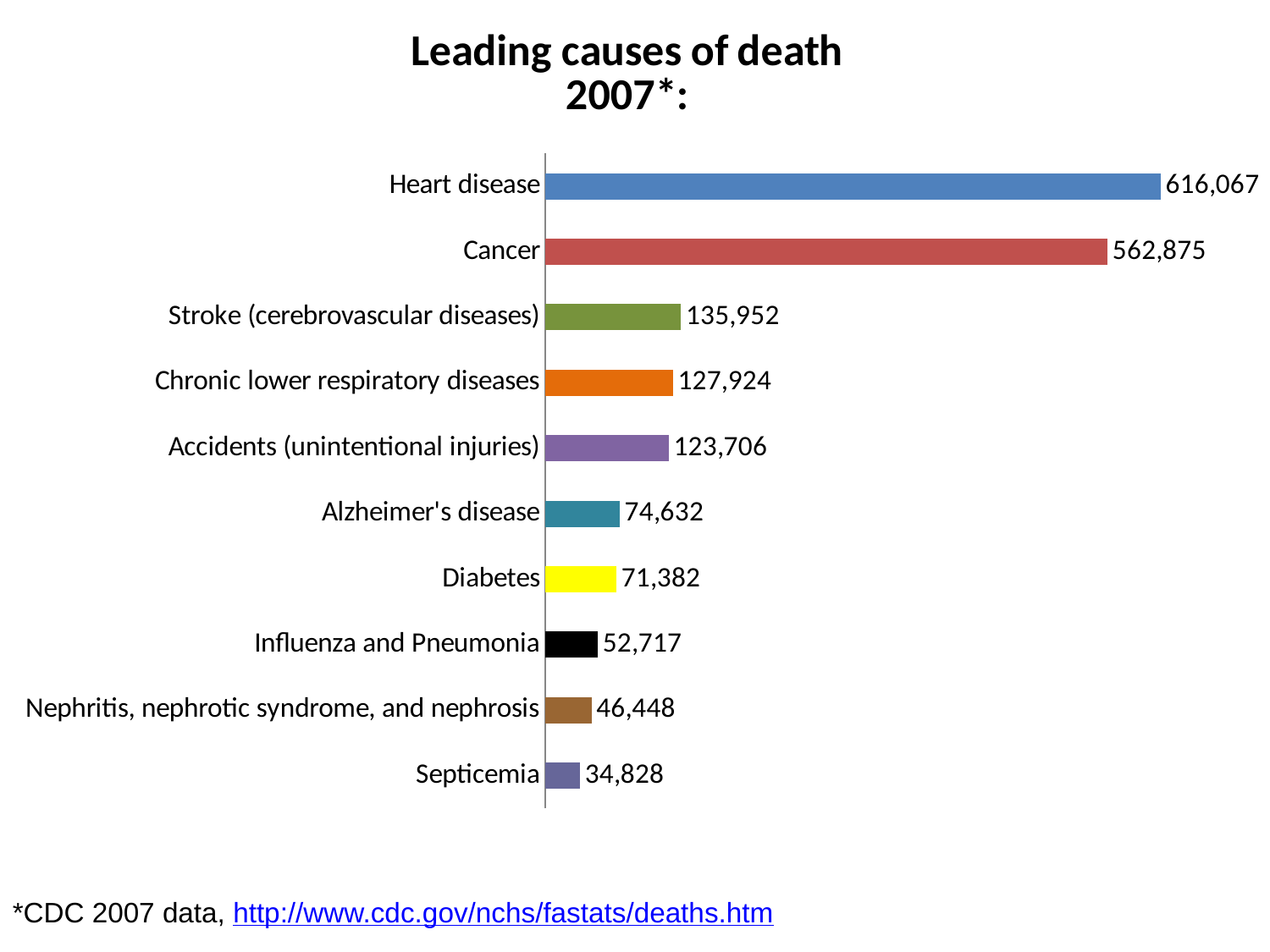
How many causes of death are shown in the chart? 10 What is the value for Nephritis, nephrotic syndrome, and nephrosis? 46,448 Which cause of death has the highest value? Heart disease Which cause of death has the lowest value? Septicemia What is the value for Heart disease? 616,067 What is the value for Alzheimer's disease? 74,632 What is the difference between the values for Heart disease and Cancer? 53,192 What is the difference between the values for Diabetes and Influenza and Pneumonia? 18,665 Which is larger, the value for Stroke (cerebrovascular diseases) or the value for Accidents (unintentional injuries)? Stroke (cerebrovascular diseases) Which is larger, the value for Alzheimer's disease or the value for Septicemia? Alzheimer's disease What is the title of the chart? Leading causes of death 2007*: What kind of chart is shown on the slide? Bar chart